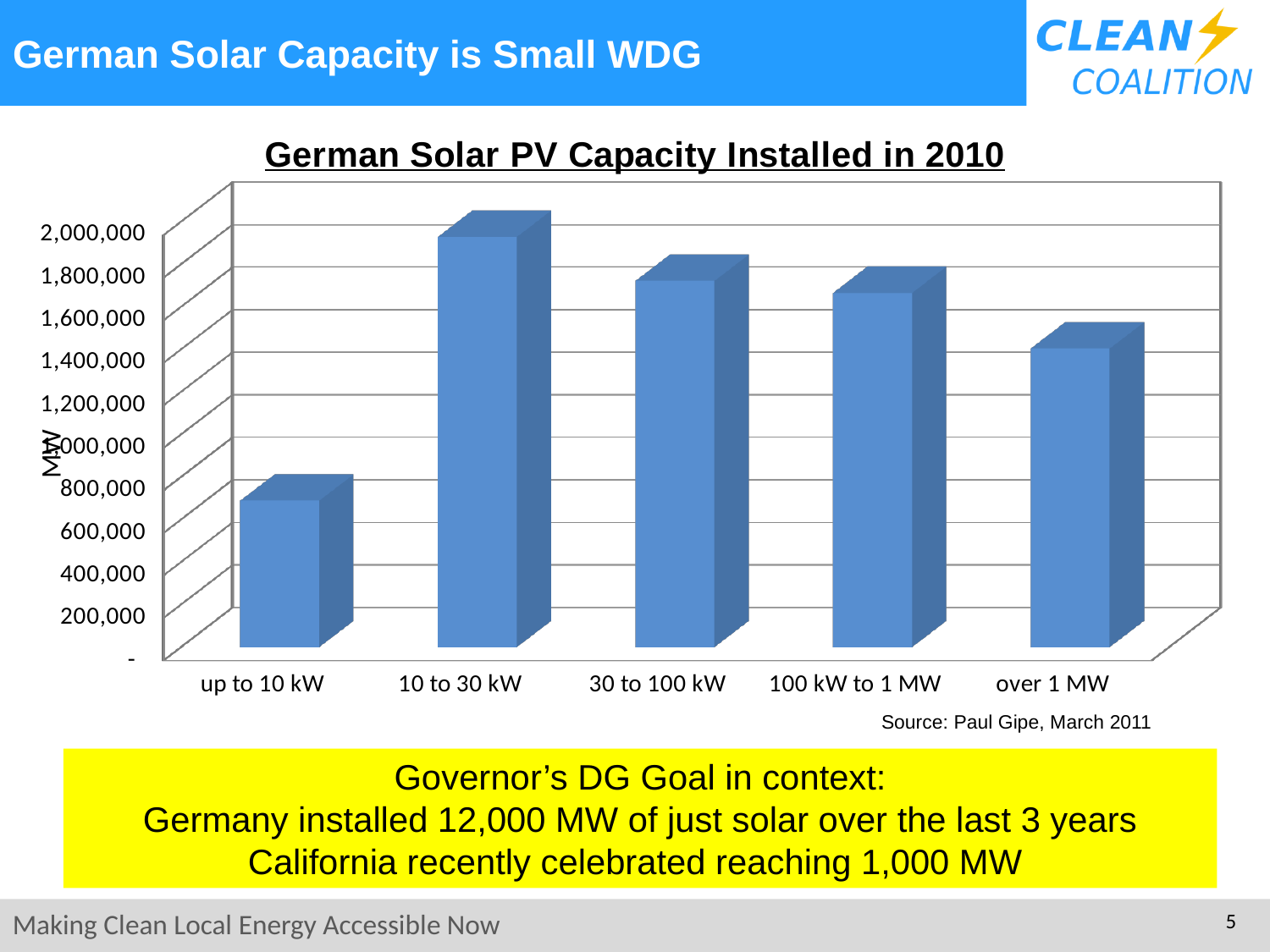
What unit is shown on the y axis of the chart? MW What is the title of the chart? German Solar PV Capacity Installed in 2010 Is the value for up to 10 kW greater or less than 800,000? less Is the value for over 1 MW greater or less than 1,200,000? greater Which size category has the highest installed capacity? 10 to 30 kW Which size category has the lowest installed capacity? up to 10 kW What kind of chart is shown on the slide? bar chart Is the value for 30 to 100 kW greater or less than 1,600,000? greater How many size categories are shown on the x axis of the chart? 5 Which has the larger installed capacity, up to 10 kW or 30 to 100 kW? 30 to 100 kW Which has the larger installed capacity, 10 to 30 kW or over 1 MW? 10 to 30 kW